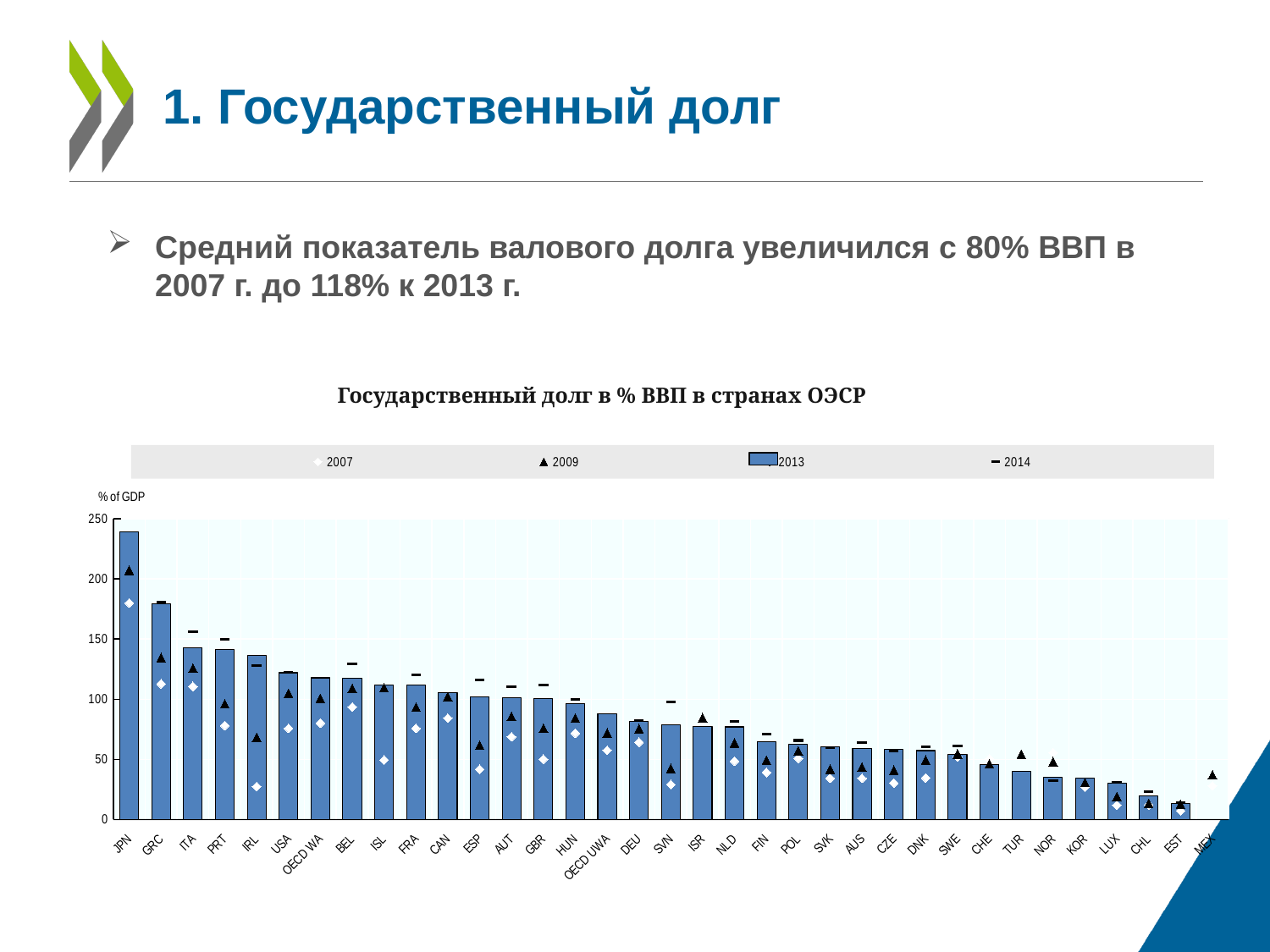
What kind of chart is shown on the slide? bar chart Is the 2013 value for DEU greater or less than 100? less Is the 2013 value for KOR greater or less than 50? less Is the 2013 value for GRC greater or less than 150? greater What is the title of the chart? Государственный долг в % ВВП в странах ОЭСР Do the 2013 bars rise or fall moving from left to right along the x axis? fall Which has the larger 2013 bar, JPN or GRC? JPN How many series does the chart legend list? 4 What is the label on the vertical axis of the chart? % of GDP Which country has the highest 2013 bar in the chart? JPN